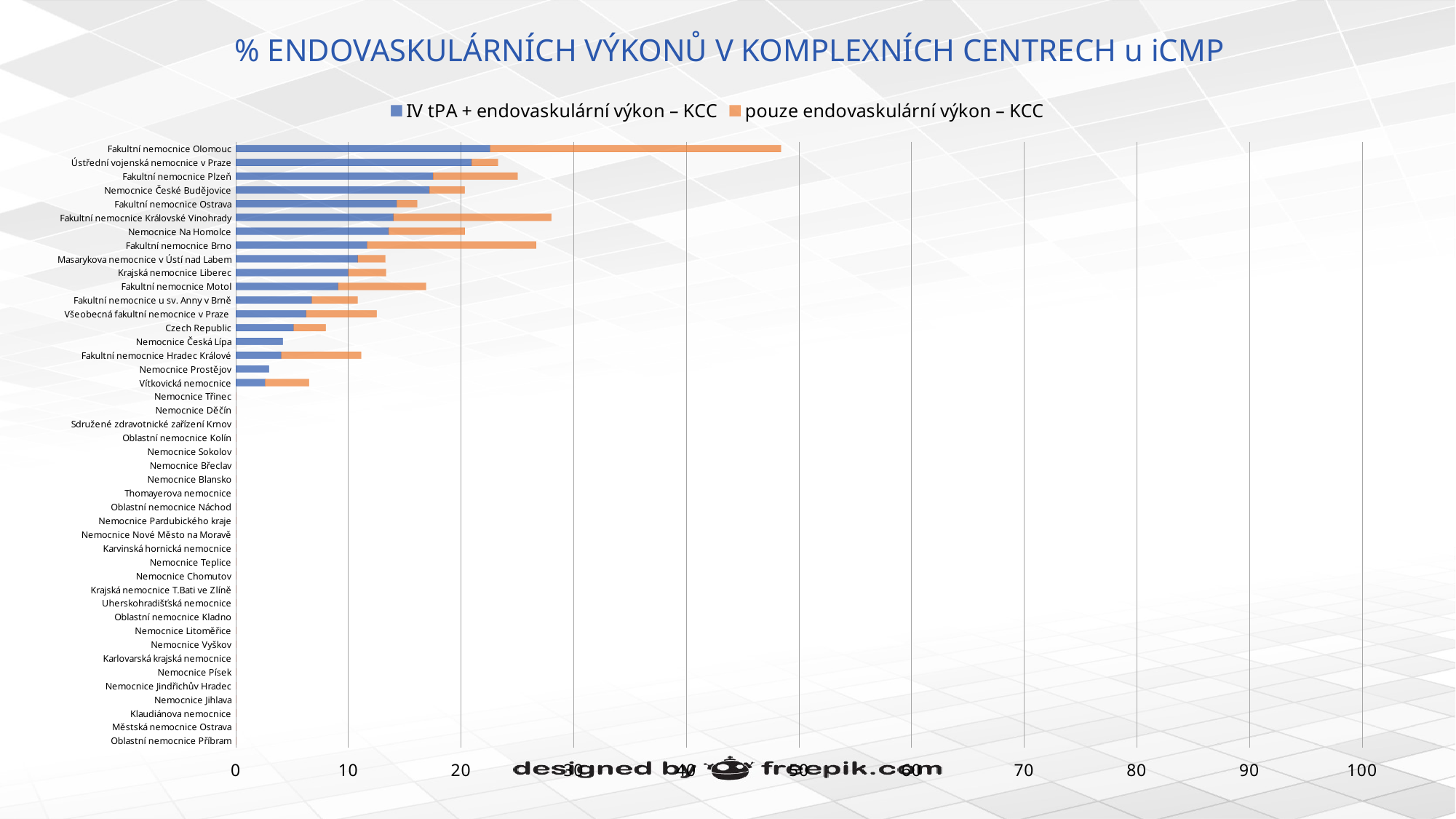
Which has the longer total bar, Fakultní nemocnice Brno or Fakultní nemocnice Motol? Fakultní nemocnice Brno Which series is shown in orange in the legend? pouze endovaskulární výkon – KCC Is the total bar for Fakultní nemocnice Olomouc greater or less than 40? greater What kind of chart is shown on the slide? bar chart How many hospitals (categories) are listed on the vertical axis? 44 How many series does the legend list? 2 Which hospital has the longest total bar? Fakultní nemocnice Olomouc Is the total bar for Fakultní nemocnice Motol greater or less than 20? less Is the total bar for Fakultní nemocnice Královské Vinohrady greater or less than 20? greater What is the title of the chart? % ENDOVASKULÁRNÍCH VÝKONŮ V KOMPLEXNÍCH CENTRECH u iCMP Which has the longer total bar, Fakultní nemocnice Olomouc or Fakultní nemocnice Plzeň? Fakultní nemocnice Olomouc